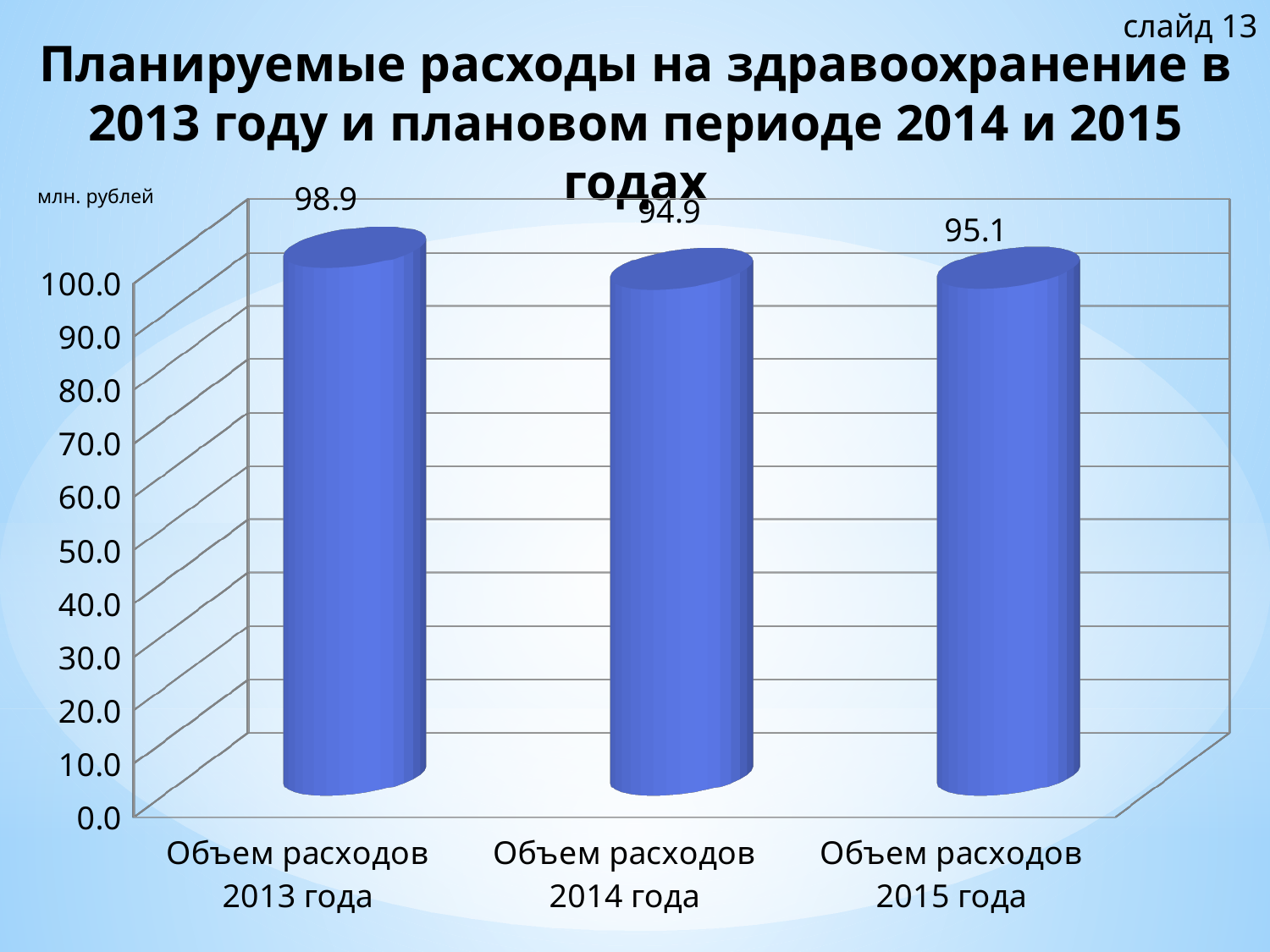
What is the difference between the 2013 and 2014 expenditure values? 4.0 What is the difference between the 2015 and 2014 expenditure values? 0.2 Is the value for Объем расходов 2013 года greater or less than 90.0? greater What is the planned healthcare expenditure for 2013 (Объем расходов 2013 года)? 98.9 Which year has the lowest planned expenditure? 2014 What is the value shown for Объем расходов 2015 года? 95.1 Which is larger, the expenditure for 2014 or for 2015? 2015 What kind of chart is shown on the slide? bar chart What is the value shown for Объем расходов 2014 года? 94.9 Which year has the highest planned expenditure? 2013 How many categories (years) are shown in the chart? 3 In what units are the values on the chart expressed? млн. рублей